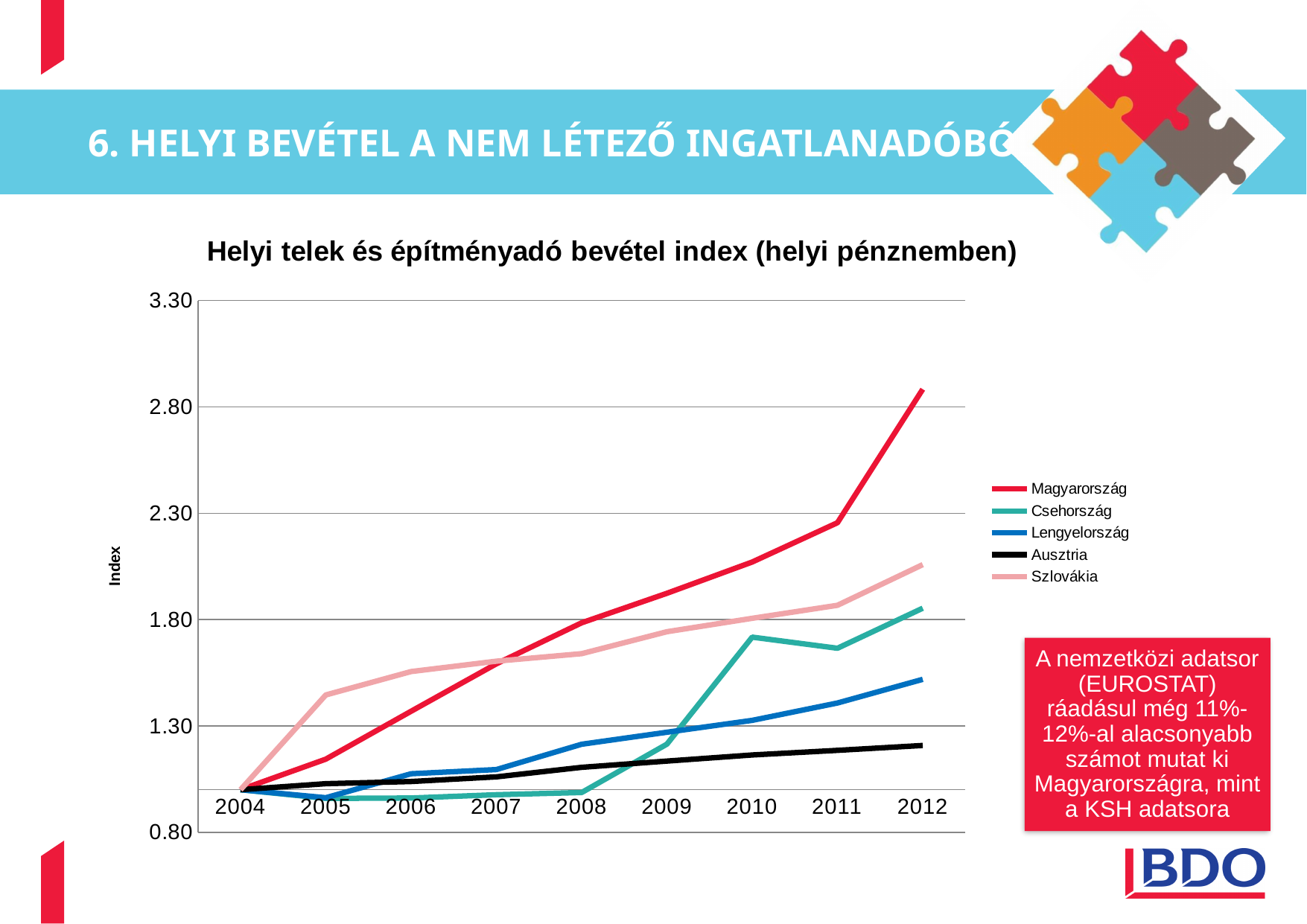
Which country has the lowest index value in 2012? Ausztria How many series does the legend list? 5 What is the title of the chart? Helyi telek és építményadó bevétel index (helyi pénznemben) In 2010, which is higher: Csehország or Lengyelország? Csehország How many years are shown along the x axis? 9 What kind of chart is shown on the slide? line chart In 2012, which is higher: Szlovákia or Csehország? Szlovákia Is the value for Magyarország in 2012 greater or less than 2.80? greater Does the index for Magyarország rise or fall from 2004 to 2012? rise Is the value for Ausztria in 2012 greater or less than 1.30? less Which country has the highest index value in 2012? Magyarország Is the value for Lengyelország in 2012 greater or less than 1.80? less